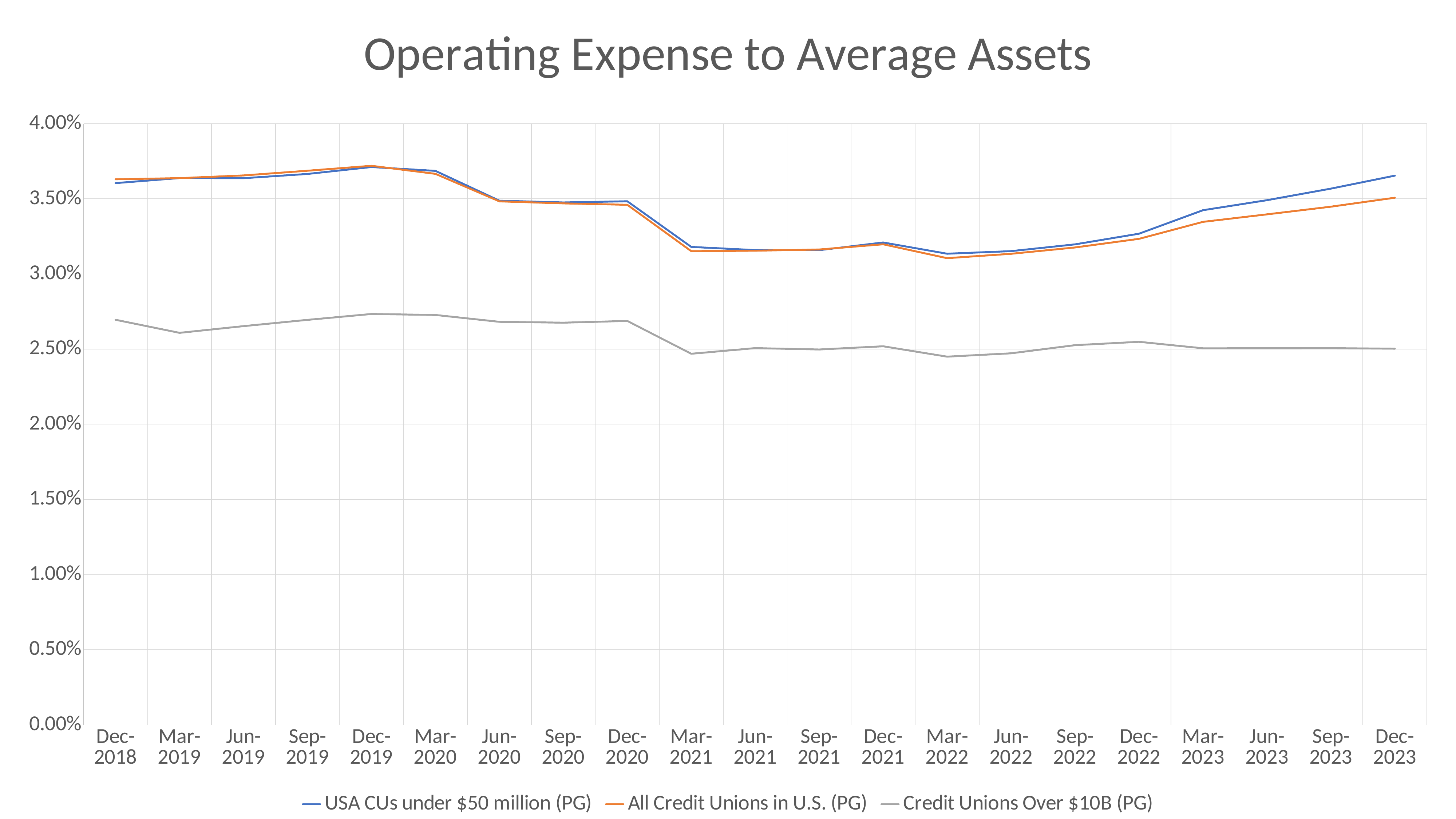
How many points are plotted along the x axis? 21 Is the value for Credit Unions Over $10B (PG) at Dec-2018 greater or less than 3.00%? less Is the value for All Credit Unions in U.S. (PG) at Mar-2022 greater or less than 3.50%? less What is the title of the chart? Operating Expense to Average Assets Which series has the lowest values throughout the chart? Credit Unions Over $10B (PG) How many series does the legend list? 3 Is the value for USA CUs under $50 million (PG) at Dec-2019 greater or less than 3.50%? greater At Dec-2023, which is larger: USA CUs under $50 million (PG) or Credit Unions Over $10B (PG)? USA CUs under $50 million (PG) What kind of chart is shown on the slide? Line chart Which series is drawn in grey? Credit Unions Over $10B (PG) Does the USA CUs under $50 million (PG) line rise or fall from Mar-2022 to Dec-2023? rise